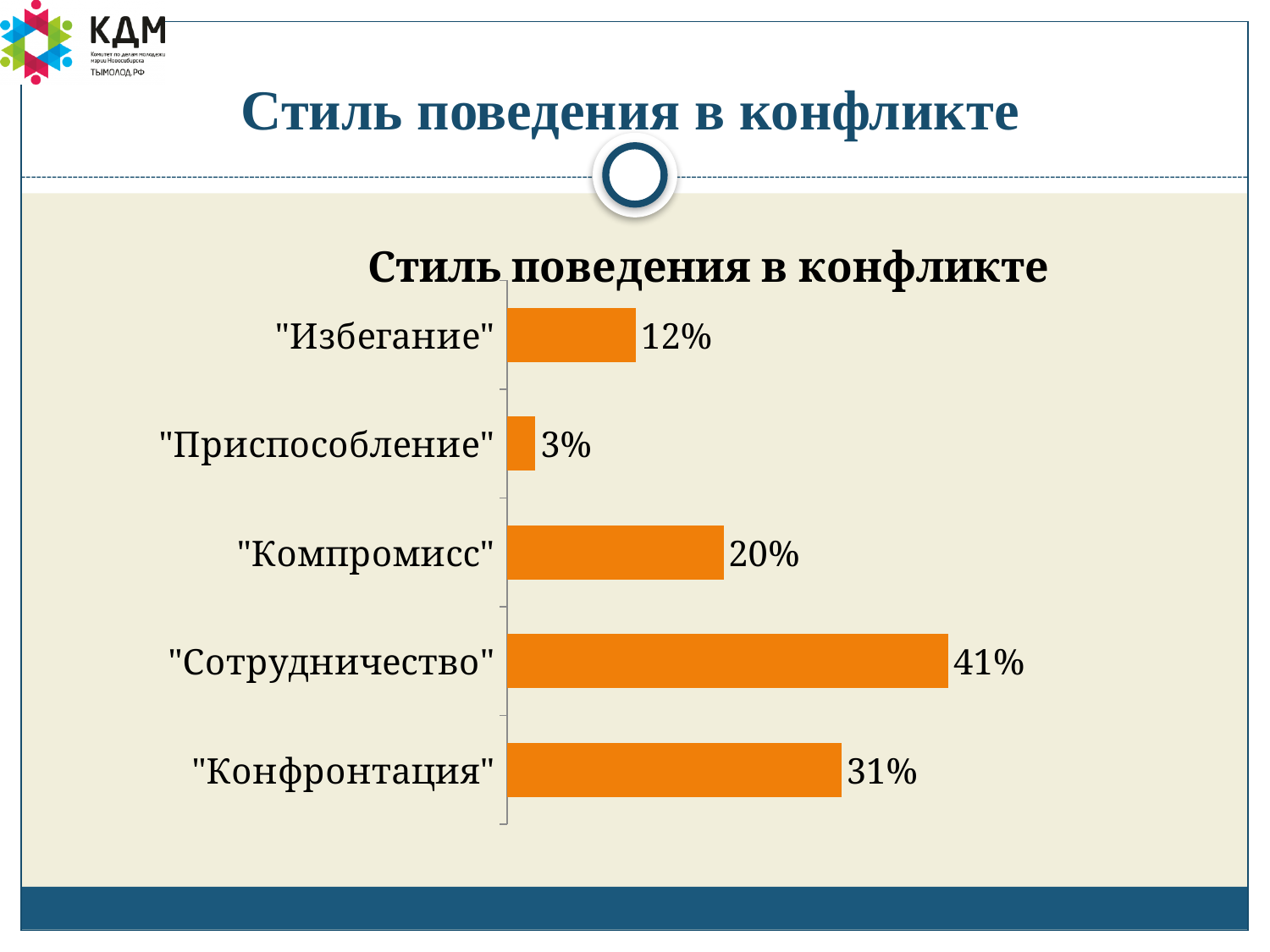
What is the value for "Приспособление"? 3% Which is larger, the value for "Конфронтация" or the value for "Компромисс"? "Конфронтация" How many categories are shown in the chart? 5 What is the title of the chart? Стиль поведения в конфликте What kind of chart is shown on the slide? Bar chart What is the value for "Сотрудничество"? 41% What is the value for "Компромисс"? 20% What is the value for "Избегание"? 12% Which category has the highest value? "Сотрудничество" What is the difference between the values for "Сотрудничество" and "Конфронтация"? 10% What is the difference between the values for "Компромисс" and "Избегание"? 8% Which category has the lowest value? "Приспособление"